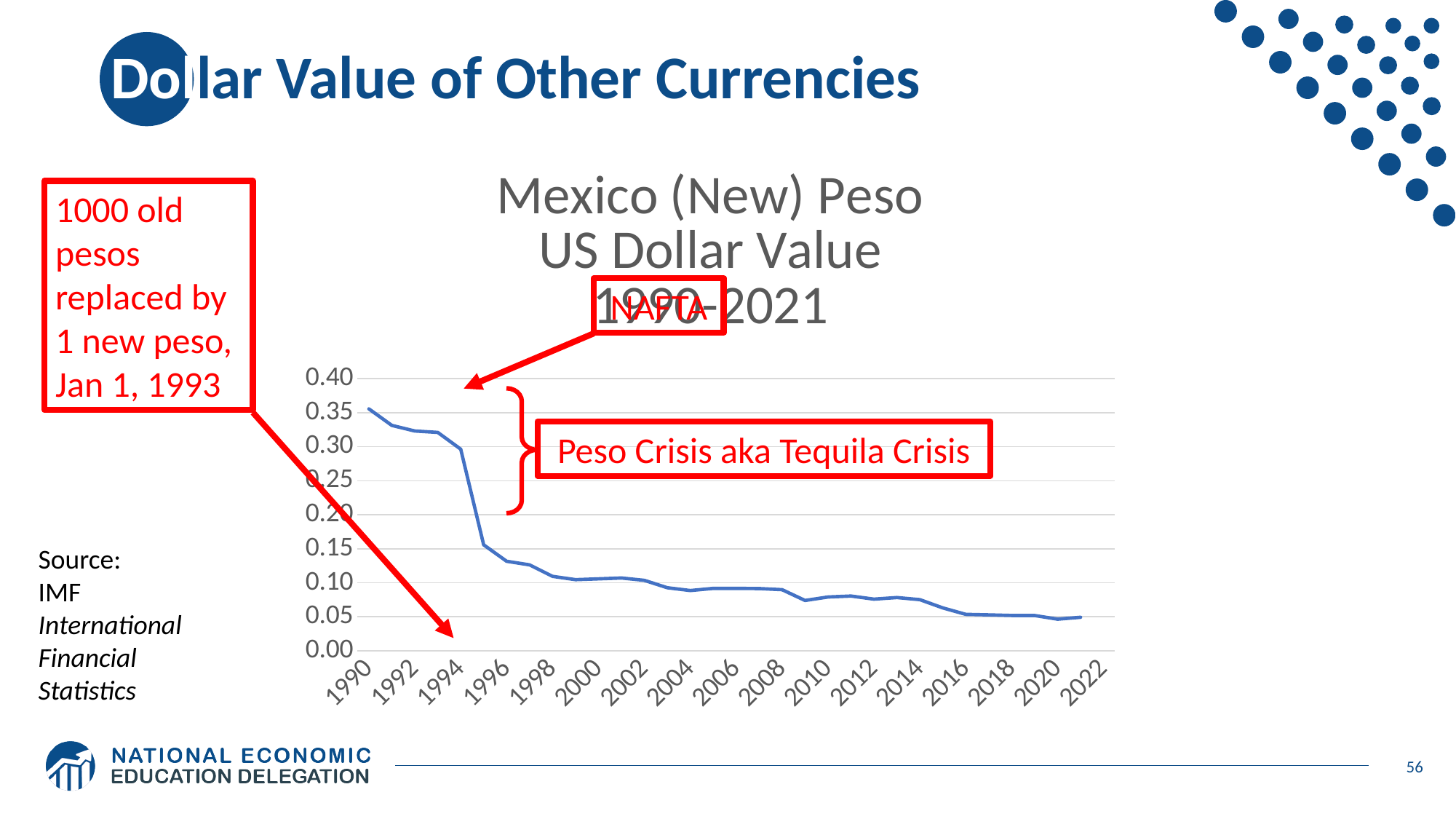
What kind of chart is shown on the slide? line chart What is the highest value shown on the y axis? 0.40 How many year labels are shown on the x axis? 17 Is the value for 1996 greater or less than 0.20? less Which is larger, the value for 1990 or the value for 2020? 1990 Is the value for 1990 greater or less than 0.30? greater Which year has the highest US dollar value of the peso on the chart? 1990 Which is larger, the value for 1994 or the value for 1996? 1994 What is the title of the chart? Mexico (New) Peso US Dollar Value 1990-2021 Is the value for 2020 greater or less than 0.10? less Does the US dollar value of the Mexican peso rise or fall from 1990 to 2021? fall